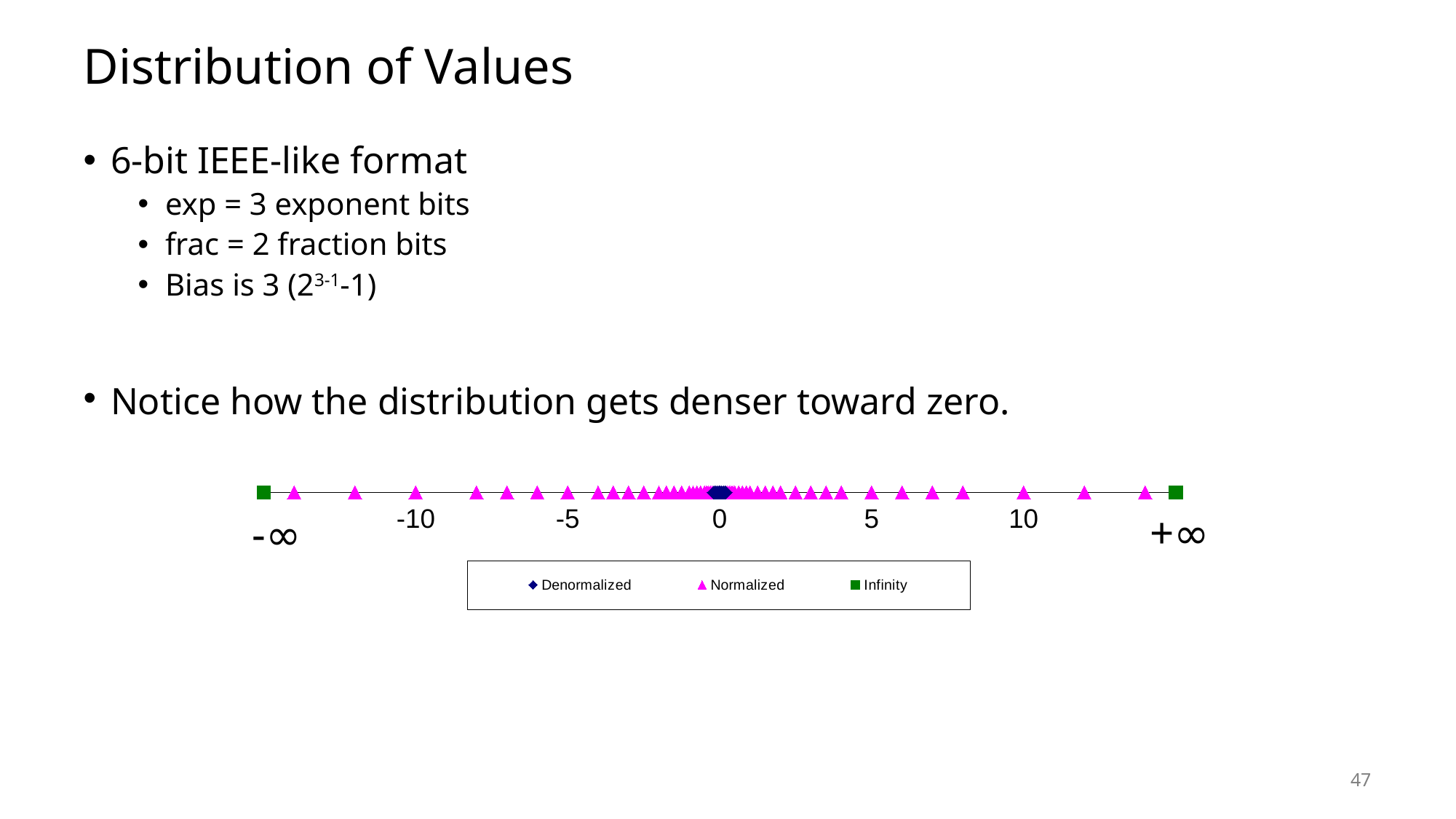
Around which x-axis value are the Denormalized markers clustered? 0 Which series has the most markers plotted on the chart? Normalized Does the spacing between Normalized markers increase or decrease as values move away from 0? increase What are the names of the series listed in the chart legend? Denormalized, Normalized, Infinity Which series has the fewest markers plotted on the chart? Infinity Which series in the chart is drawn with green square markers? Infinity Is the value of the leftmost Infinity marker greater or less than -10? less How many Infinity markers are plotted on the chart? 2 How many series does the chart legend list? 3 Is the value of the rightmost Infinity marker greater or less than 10? greater What kind of chart is shown on the slide? scatter plot How many numeric tick labels are shown on the chart's x axis? 5